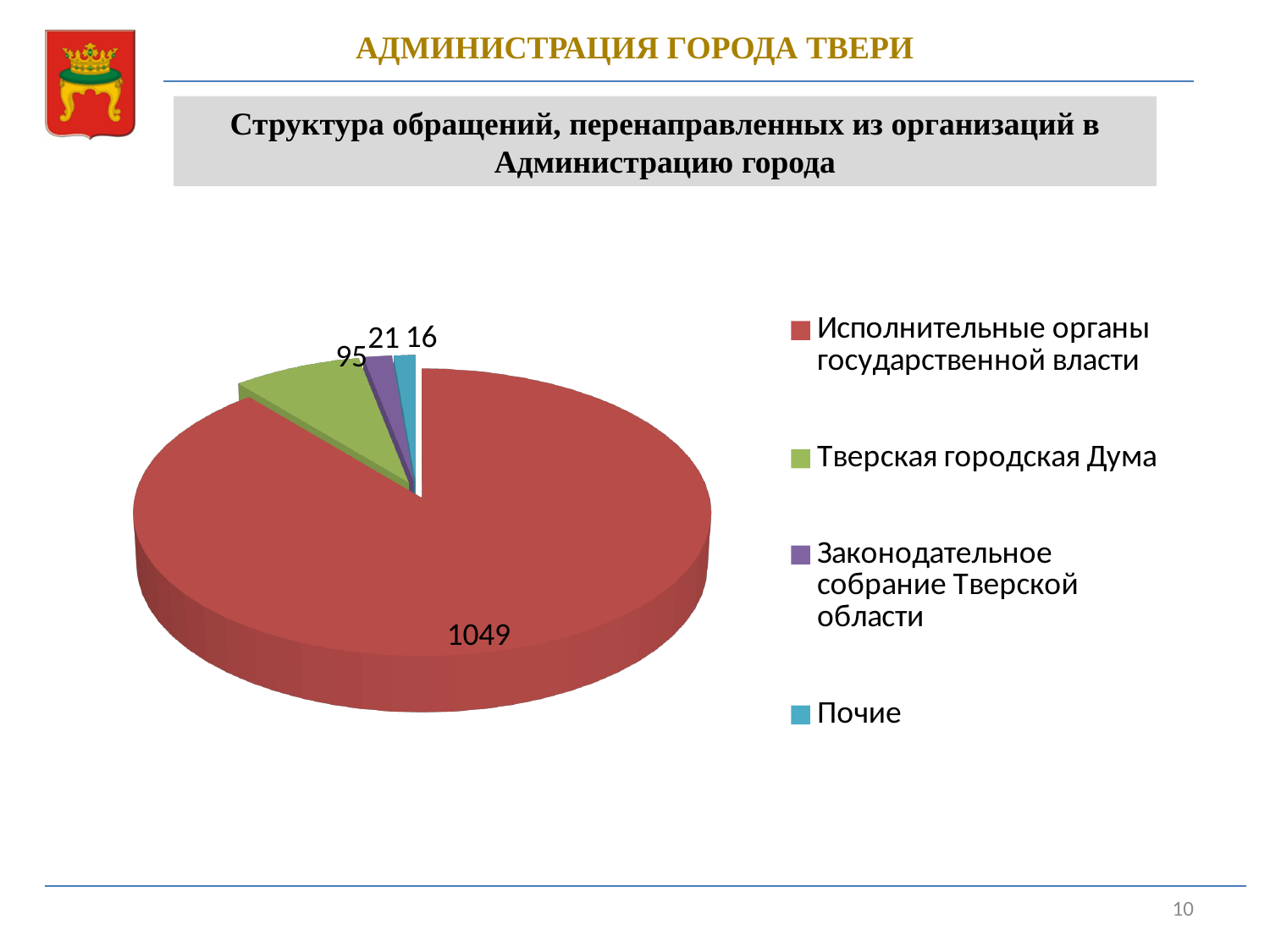
What is the value for Почие? 16 What is the difference between the values for Исполнительные органы государственной власти and Тверская городская Дума? 954 What is the difference between the values for Законодательное собрание Тверской области and Почие? 5 What type of chart is shown on the slide? Pie chart Which category has the largest slice of the pie? Исполнительные органы государственной власти Which category has the smallest slice of the pie? Почие What is the value for Исполнительные органы государственной власти? 1049 What is the value for Законодательное собрание Тверской области? 21 What is the title of the chart on the slide? Структура обращений, перенаправленных из организаций в Администрацию города What is the value for Тверская городская Дума? 95 How many categories does the pie chart have? 4 Which is larger: the value for Тверская городская Дума or the value for Законодательное собрание Тверской области? Тверская городская Дума